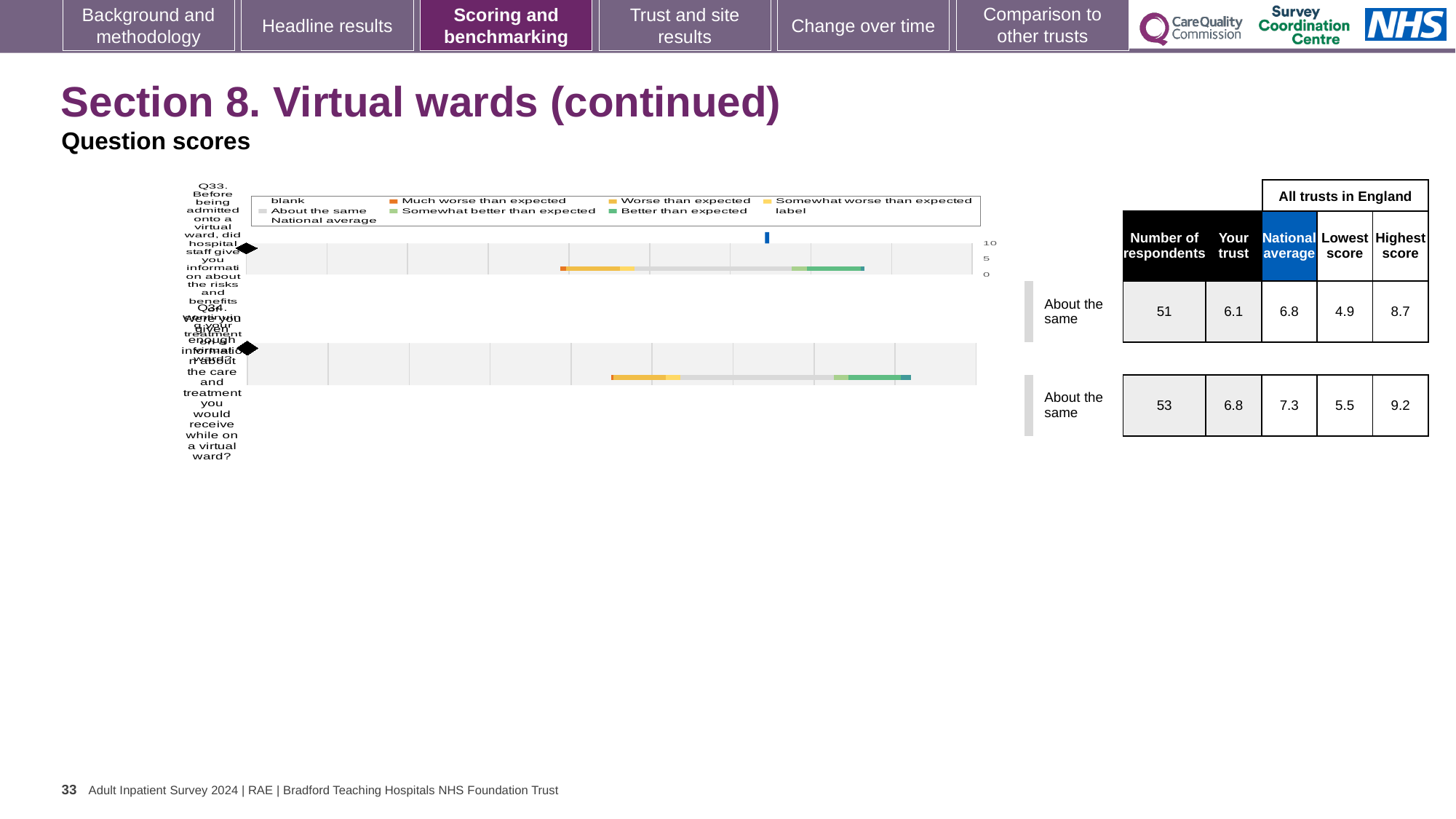
What kind of chart is used to show the question scores for Q33 and Q34? bar chart Which question has the higher 'Your trust' score, Q33 or Q34? Q34 How many questions are plotted in the chart? 2 What colour represents 'Much worse than expected' in the legend? orange What is the lowest score among all trusts in England for Q34? 5.5 How many respondents answered Q33? 51 What is the national average score for Q34 (enough information about care and treatment on a virtual ward)? 7.3 Is the 'Your trust' score for Q33 higher or lower than the national average for Q33? lower By how much does the national average for Q34 exceed the 'Your trust' score for Q34? 0.5 What is the difference between the highest score and the lowest score for Q33? 3.8 What benchmark category is shown for Q34? About the same What is the 'Your trust' score for Q33 (information about the risks and benefits of a virtual ward)? 6.1